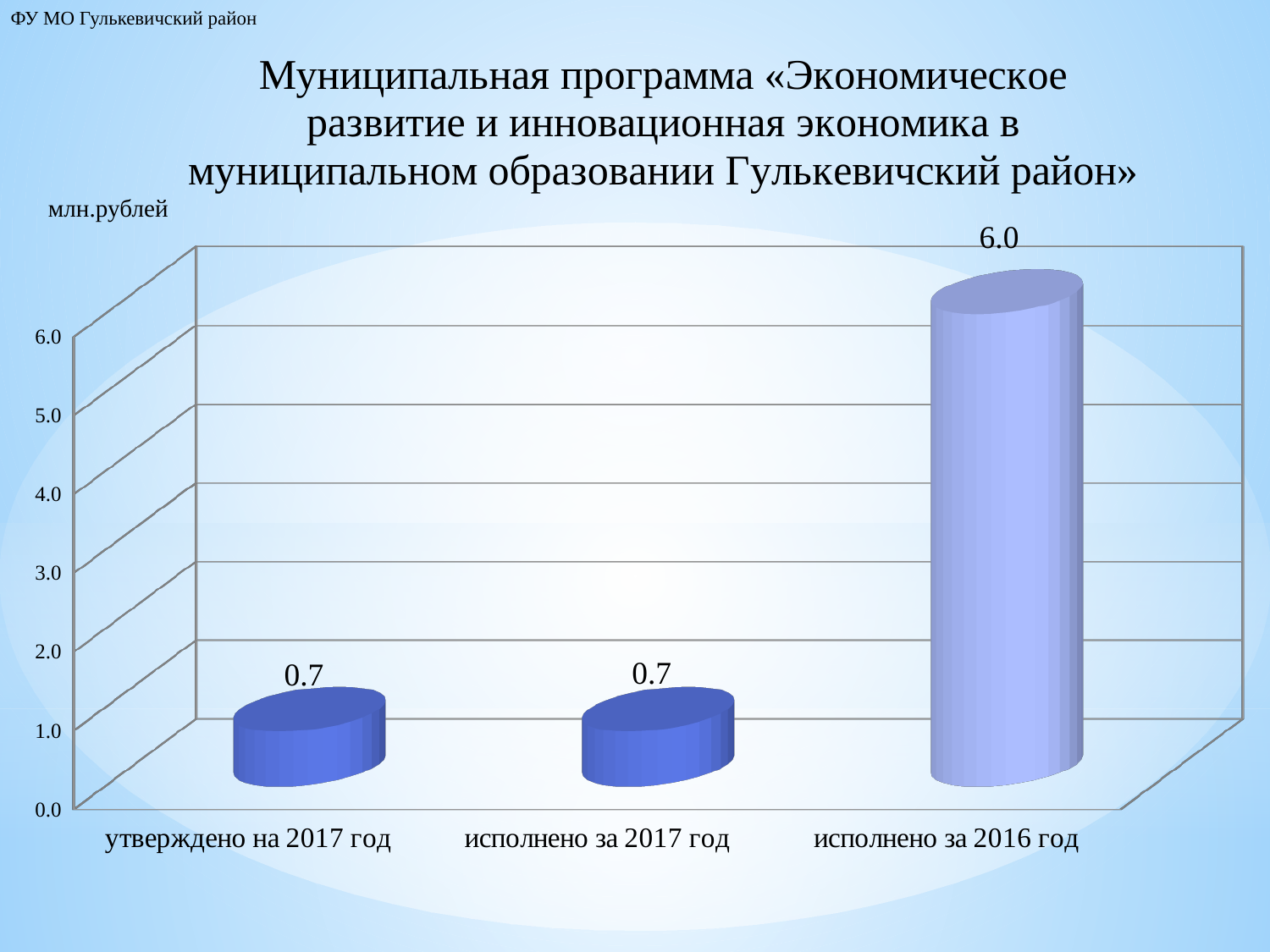
What is the value for «исполнено за 2016 год»? 6.0 How many categories are shown on the chart? 3 What is the total of the values for «утверждено на 2017 год» and «исполнено за 2017 год»? 1.4 Which is larger: the value for «исполнено за 2016 год» or the value for «утверждено на 2017 год»? исполнено за 2016 год What kind of chart is shown on the slide? bar chart What is the value for «исполнено за 2017 год»? 0.7 Is the value for «исполнено за 2016 год» greater or less than 5.0? greater Which category has the highest value? исполнено за 2016 год What is the difference between the value for «исполнено за 2016 год» and the value for «исполнено за 2017 год»? 5.3 Is the value for «утверждено на 2017 год» greater or less than 1.0? less What unit of measurement is indicated for the chart values? млн.рублей What is the value for «утверждено на 2017 год»? 0.7